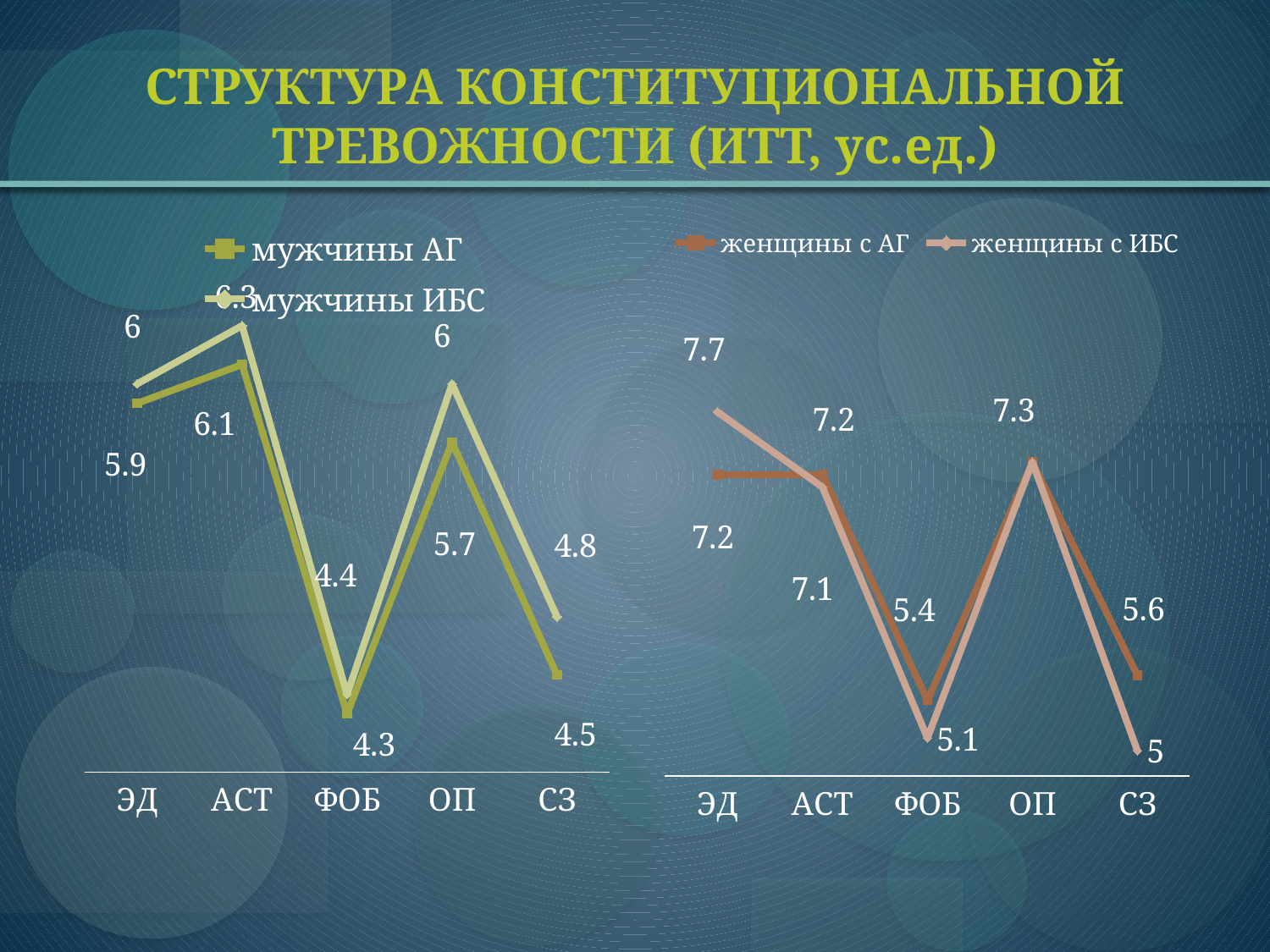
In the right chart, what is the value for женщины с ИБС at ЭД? 7.7 What kind of chart is shown on the left side of the slide? line chart In the left chart, what is the value for мужчины ИБС at АСТ? 6.3 In the left chart, what is the value for мужчины АГ at ФОБ? 4.3 In the left chart, which category has the lowest value for мужчины ИБС? ФОБ How many categories are shown on the x axis of the right chart? 5 In the right chart, which is larger at ФОБ: женщины с АГ or женщины с ИБС? женщины с АГ How many series does the legend of the right chart list? 2 In the right chart, do the values for женщины с ИБС rise or fall from ЭД to ФОБ? fall In the left chart, what is the difference between мужчины ИБС and мужчины АГ at СЗ? 0.3 In the left chart, what is the value for мужчины АГ at ОП? 5.7 In the right chart, what is the value for женщины с АГ at СЗ? 5.6